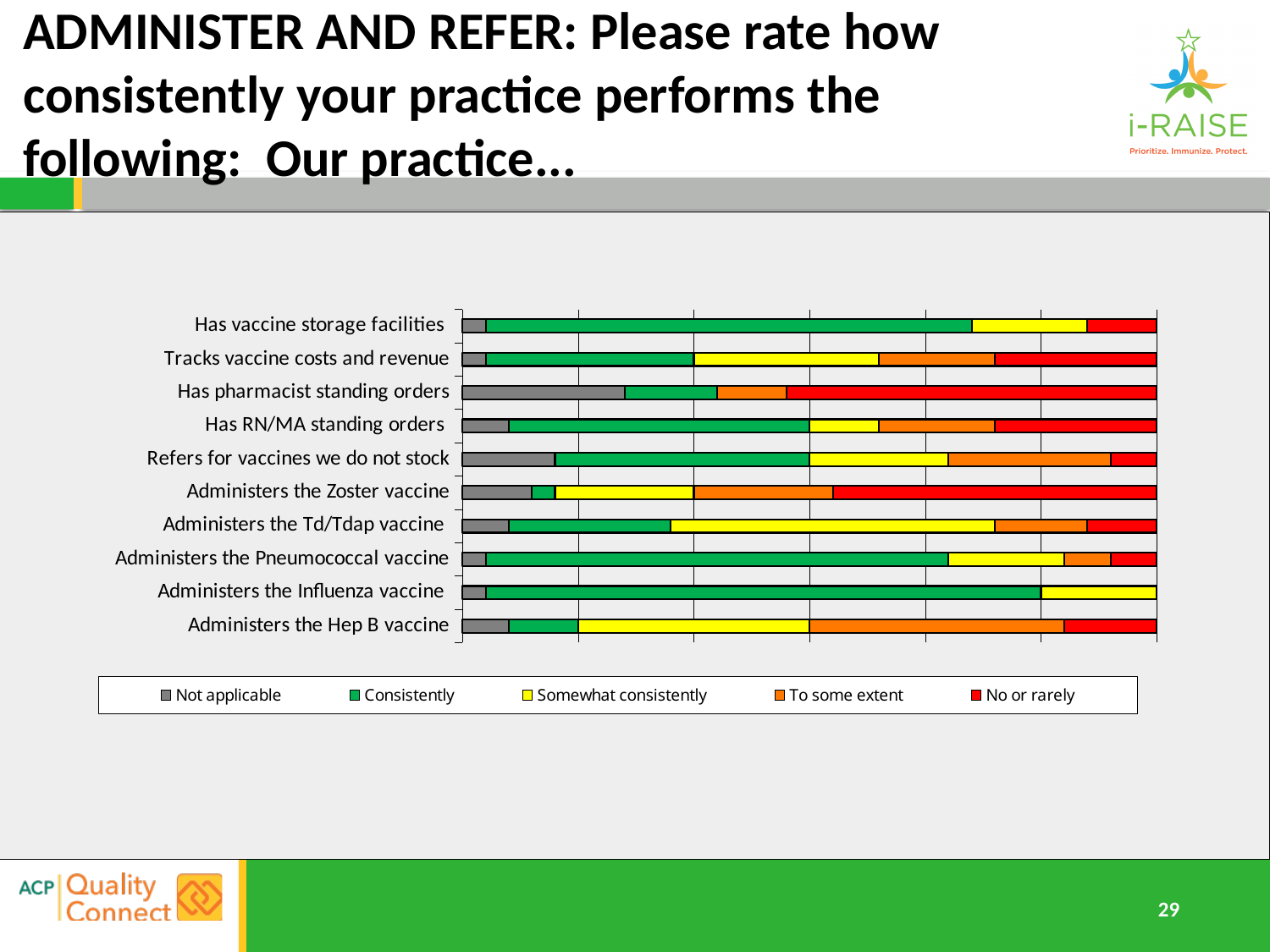
How many series does the chart legend list? 5 Which category has the largest 'Not applicable' segment? Has pharmacist standing orders Which category has the largest 'To some extent' segment? Administers the Hep B vaccine Which category has the largest 'Consistently' segment? Administers the Influenza vaccine Which has the larger 'Consistently' segment: Administers the Td/Tdap vaccine or Administers the Hep B vaccine? Administers the Td/Tdap vaccine What kind of chart is shown on the slide? Stacked bar chart Which category has the smallest 'Consistently' segment? Administers the Zoster vaccine How many practice activities (categories) are listed on the chart? 10 Which category is listed at the top of the chart? Has vaccine storage facilities Which colour represents 'Consistently' in the chart legend? Green